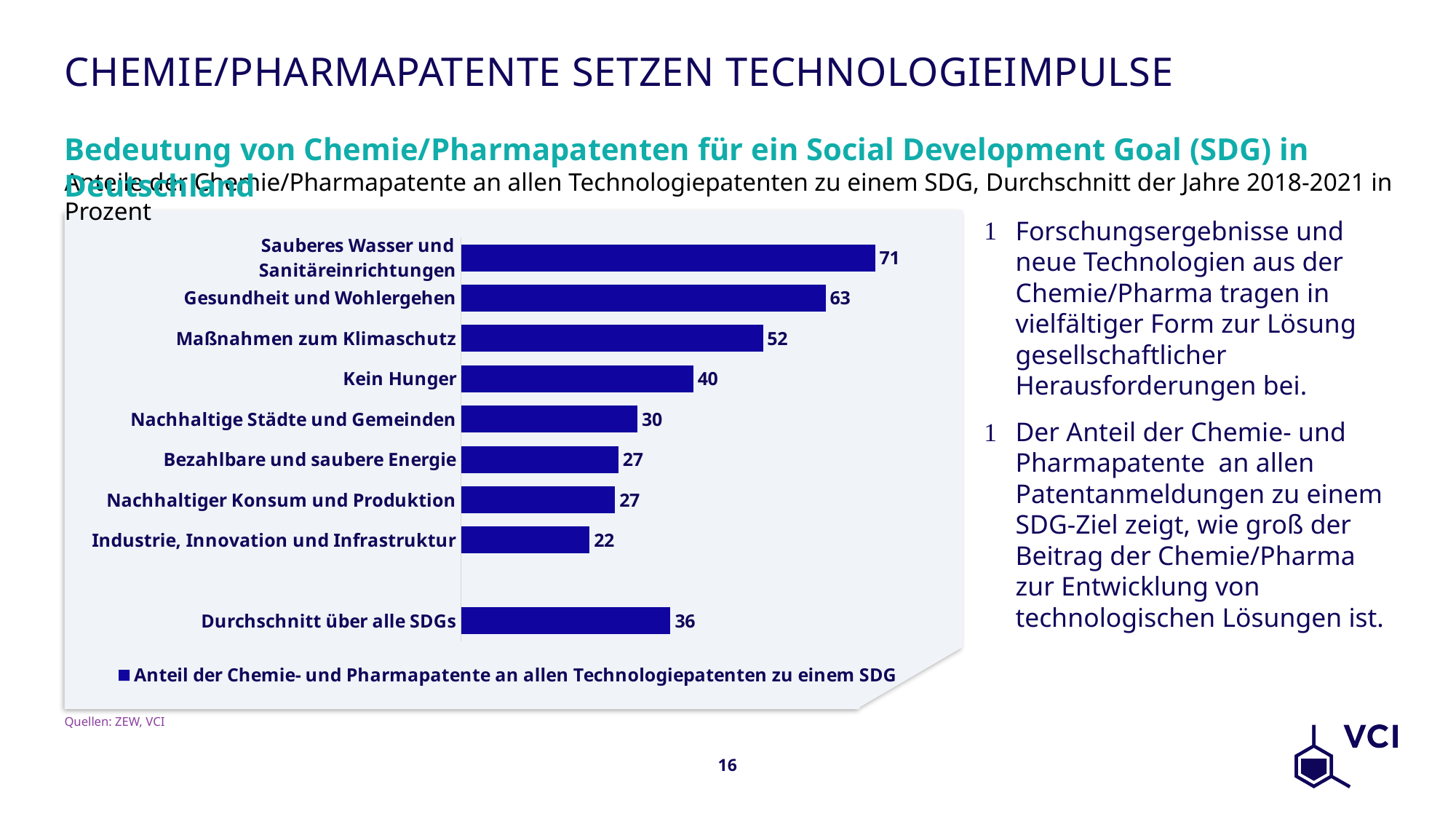
What is the difference between the values for Maßnahmen zum Klimaschutz and Kein Hunger? 12 How many categories are shown in the chart? 9 Which category has the lowest value? Industrie, Innovation und Infrastruktur What kind of chart is shown on the slide? Bar chart What is the value for Kein Hunger? 40 Which category has the highest value? Sauberes Wasser und Sanitäreinrichtungen What is the legend entry of the chart? Anteil der Chemie- und Pharmapatente an allen Technologiepatenten zu einem SDG What is the value for Sauberes Wasser und Sanitäreinrichtungen? 71 What is the value for Durchschnitt über alle SDGs? 36 Which is larger, the value for Nachhaltige Städte und Gemeinden or the value for Industrie, Innovation und Infrastruktur? Nachhaltige Städte und Gemeinden What is the difference between the values for Sauberes Wasser und Sanitäreinrichtungen and Gesundheit und Wohlergehen? 8 What is the value for Gesundheit und Wohlergehen? 63